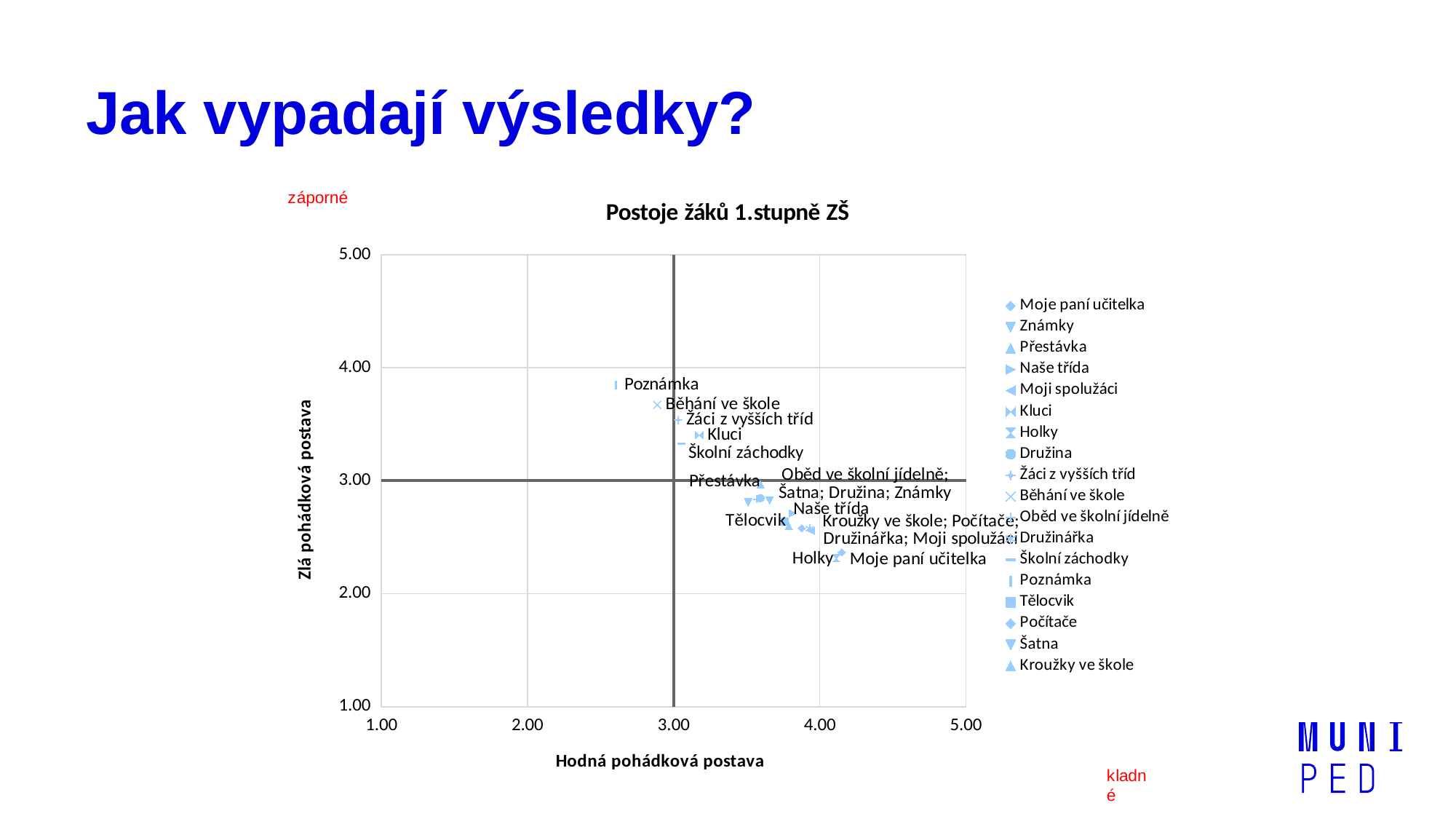
How many series does the legend list? 18 Is the vertical-axis value for Běhání ve škole greater or less than 3.00? greater What is the title of the chart? Postoje žáků 1.stupně ZŠ Is the vertical-axis value for Holky greater or less than 3.00? less Which series has the highest value on the vertical axis (Zlá pohádková postava)? Poznámka Is the horizontal-axis value for Tělocvik greater or less than 4.00? less Which has the higher vertical-axis value, Kluci or Tělocvik? Kluci What is the label of the horizontal axis? Hodná pohádková postava Which series has the lowest value on the horizontal axis (Hodná pohádková postava)? Poznámka What kind of chart is shown on the slide? scatter chart